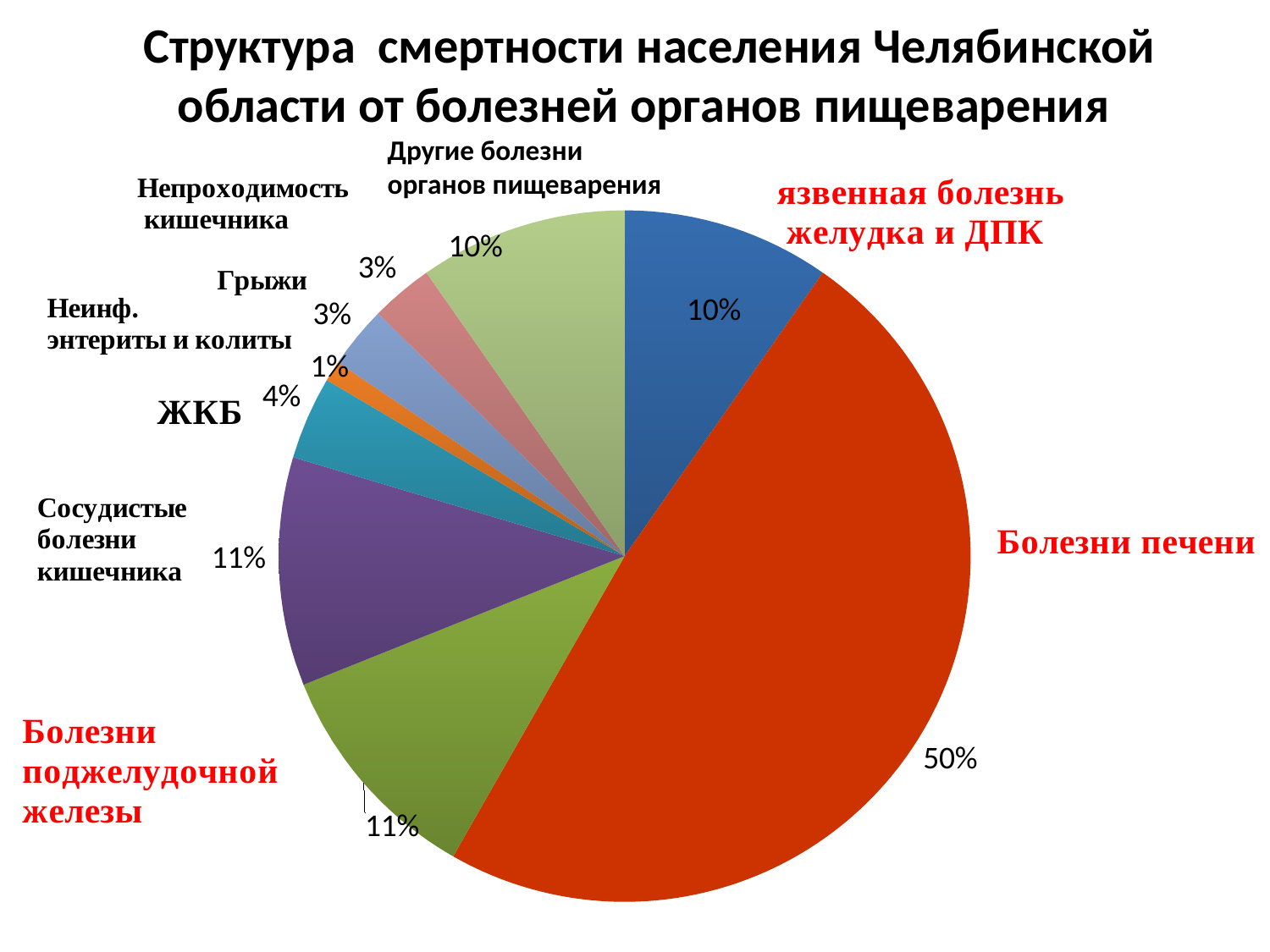
What is the title of the slide? Структура смертности населения Челябинской области от болезней органов пищеварения Which is larger: the share for ЖКБ or the share for Непроходимость кишечника? ЖКБ What share of the pie does Болезни печени account for? 50% Which category has the smallest slice of the pie? Неинф. энтериты и колиты What is the difference between the share for Болезни печени and the share for Болезни поджелудочной железы? 39% What is the value shown for язвенная болезнь желудка и ДПК? 10% What is the value shown for Сосудистые болезни кишечника? 11% What is the value shown for Грыжи? 3% How many slices does the pie chart have? 9 What is the value shown for ЖКБ? 4% Which category has the largest slice of the pie? Болезни печени What kind of chart is shown on the slide? pie chart